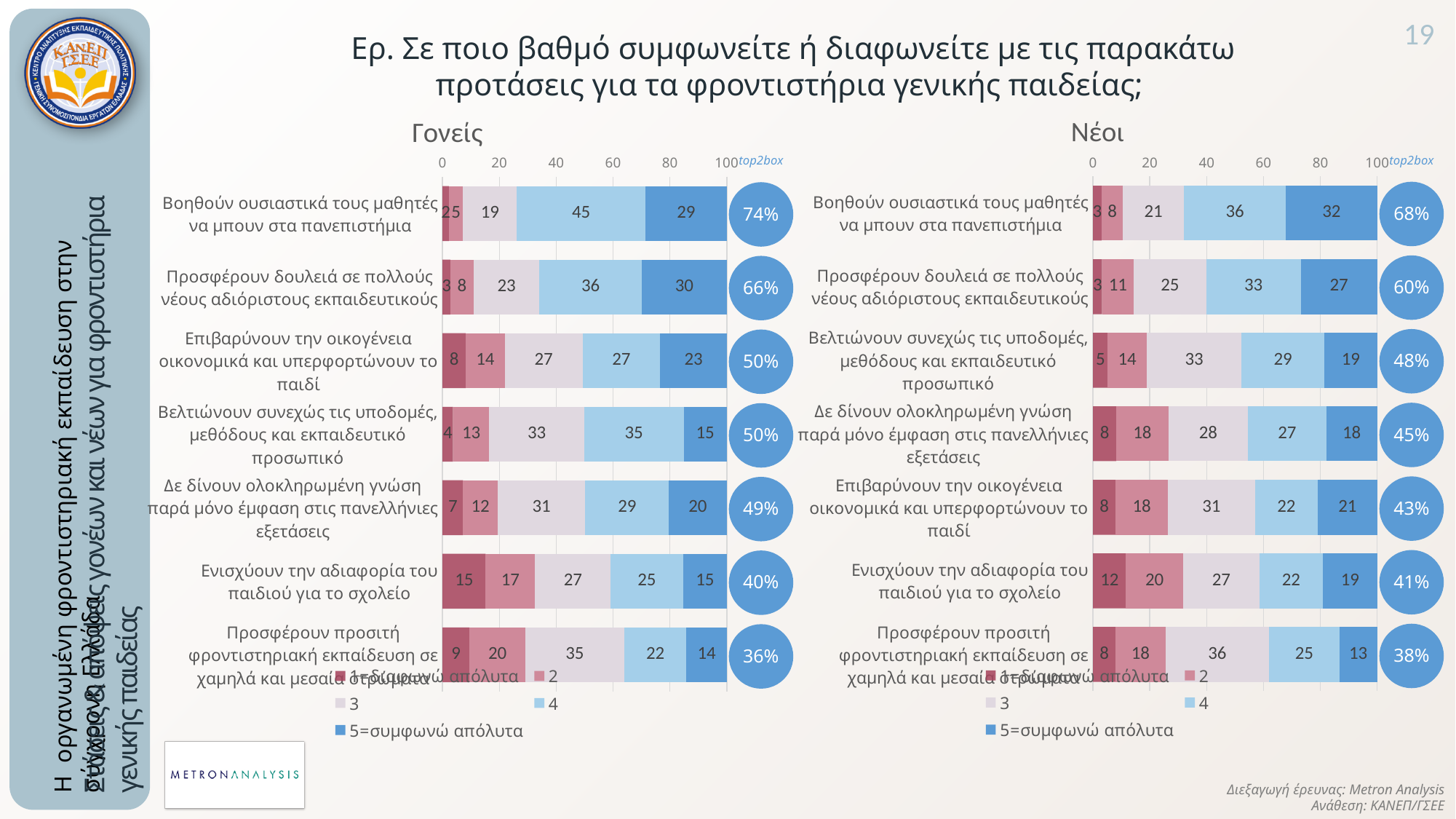
What type of chart is the Γονείς chart? Stacked bar chart In the Νέοι chart, what is the value of the '4' segment for 'Βελτιώνουν συνεχώς τις υποδομές, μεθόδους και εκπαιδευτικό προσωπικό'? 29 In the Γονείς chart, what is the value of the '5=συμφωνώ απόλυτα' segment for 'Βοηθούν ουσιαστικά τους μαθητές να μπουν στα πανεπιστήμια'? 29 In the Γονείς chart, which statement has the highest top2box percentage? Βοηθούν ουσιαστικά τους μαθητές να μπουν στα πανεπιστήμια In the Νέοι chart, what is the value of the '3' segment for 'Προσφέρουν προσιτή φροντιστηριακή εκπαίδευση σε χαμηλά και μεσαία στρώματα'? 36 In the Νέοι chart, what is the sum of the '4' and '5=συμφωνώ απόλυτα' segments for 'Ενισχύουν την αδιαφορία του παιδιού για το σχολείο'? 41 What is the difference between the top2box percentage for 'Βοηθούν ουσιαστικά τους μαθητές να μπουν στα πανεπιστήμια' in the Γονείς chart and in the Νέοι chart? 6 percentage points In the Γονείς chart, what is the top2box percentage for 'Προσφέρουν δουλειά σε πολλούς νέους αδιόριστους εκπαιδευτικούς'? 66% How many series does the legend of the Νέοι chart list? 5 How many statements (categories) are shown in the Γονείς chart? 7 In the Γονείς chart, which is larger for 'Ενισχύουν την αδιαφορία του παιδιού για το σχολείο': the '1=διαφωνώ απόλυτα' segment or the '2' segment? 2 In the Νέοι chart, which statement has the lowest top2box percentage? Προσφέρουν προσιτή φροντιστηριακή εκπαίδευση σε χαμηλά και μεσαία στρώματα